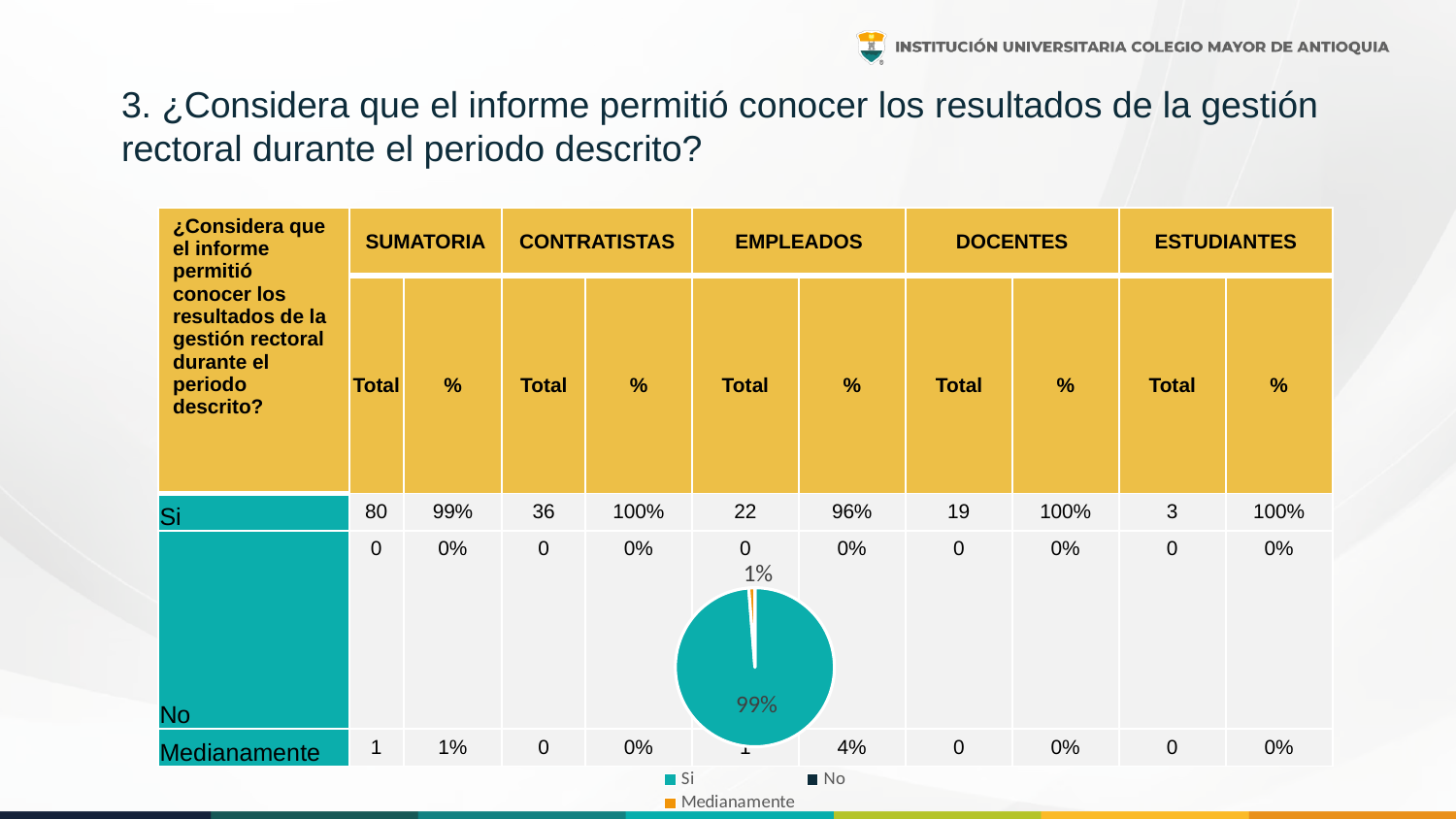
What is the difference in percentage points between the Si slice and the Medianamente slice in the pie chart? 98 What share of the pie chart does the Medianamente slice represent? 1% How many entries does the legend of the pie chart list? 3 Which is larger in the pie chart, the Si slice or the Medianamente slice? Si What colour is the Si slice in the pie chart? teal How many percentage labels are printed on the pie chart? 2 What share of the pie chart does the Si slice represent? 99% What kind of chart is shown on the slide? pie chart Which category has the largest slice in the pie chart? Si Is the share of the Si slice in the pie chart greater or less than 50%? greater Which legend entries are listed for the pie chart? Si, No, Medianamente